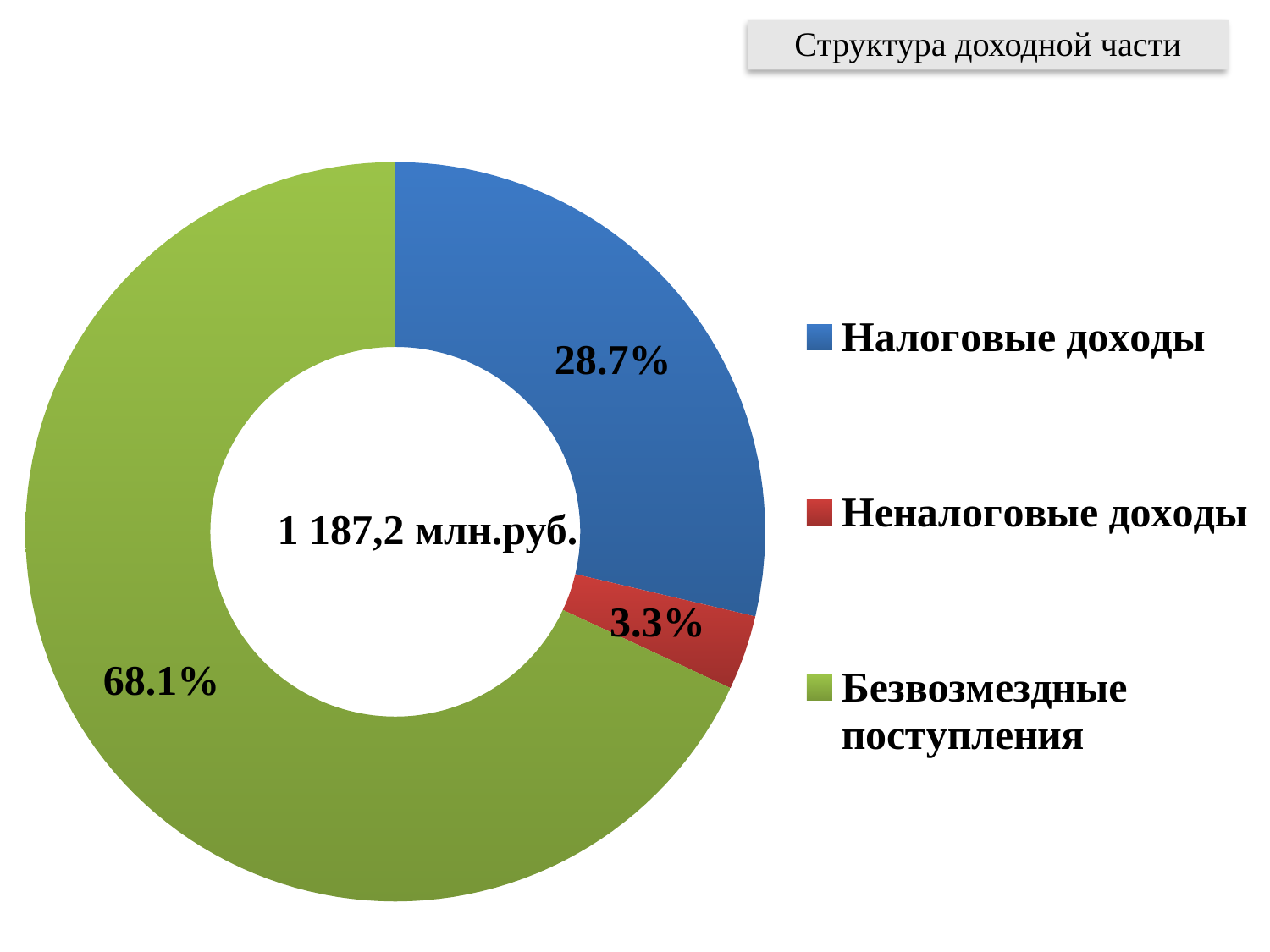
What total value is printed in the centre of the chart? 1 187,2 млн.руб. What is the difference in percentage points between Налоговые доходы and Неналоговые доходы? 25.4 Which is larger, the share for Налоговые доходы or the share for Неналоговые доходы? Налоговые доходы What is the difference in percentage points between Безвозмездные поступления and Налоговые доходы? 39.4 What colour represents Безвозмездные поступления in the chart? Green What share of the chart does Налоговые доходы represent? 28.7% What share of the chart does Безвозмездные поступления represent? 68.1% What share of the chart does Неналоговые доходы represent? 3.3% How many categories does the chart show? 3 What kind of chart is shown on the slide? Pie chart (doughnut) Which category has the smallest share of the chart? Неналоговые доходы Which category has the largest share of the chart? Безвозмездные поступления